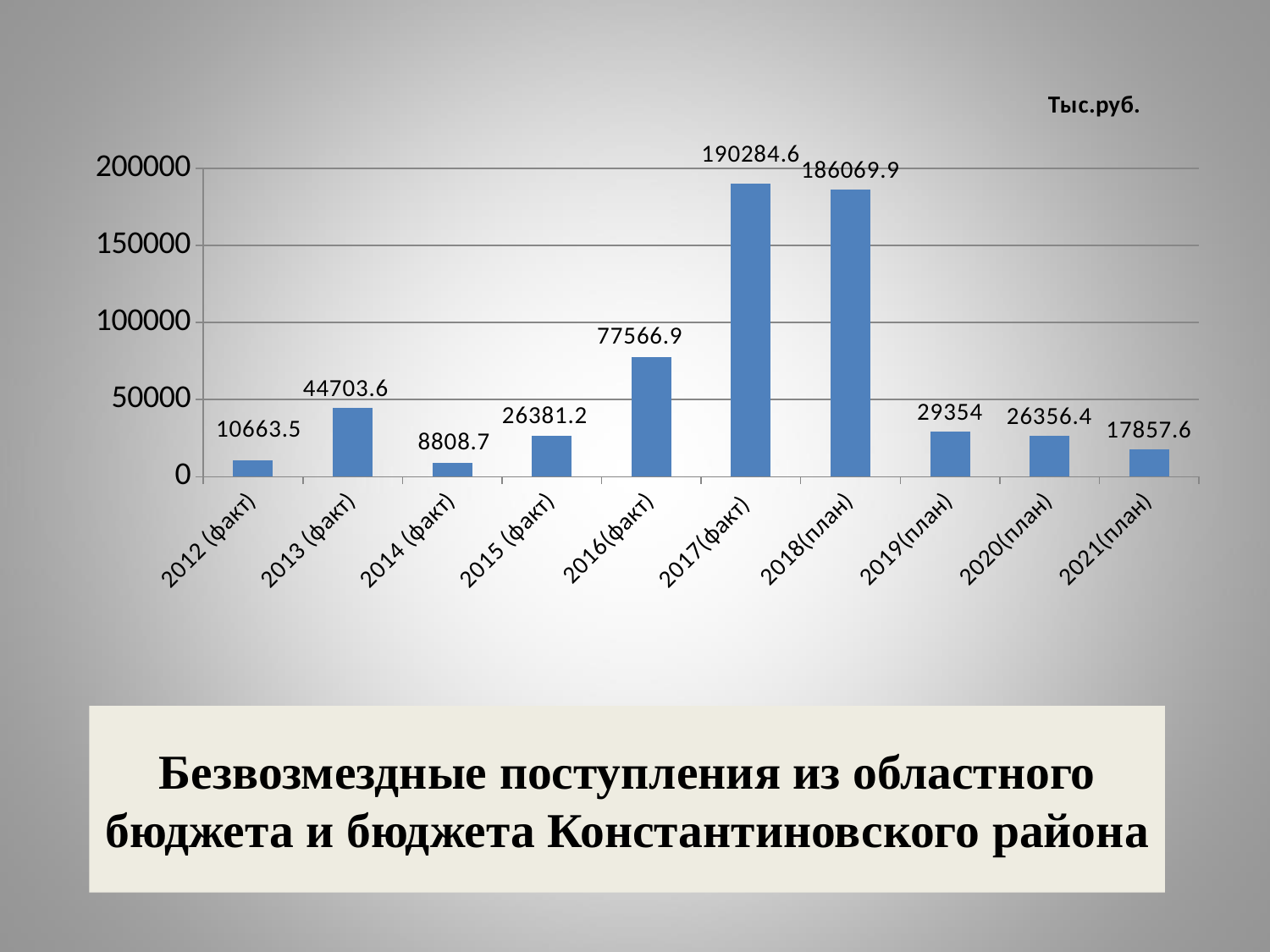
What is the value for 2017(факт)? 190284.6 Is the value for 2016(факт) greater or less than 50000? greater What kind of chart is shown on the slide? bar chart Which category has the highest value? 2017(факт) How many categories are shown on the x axis? 10 What is the value for 2019(план)? 29354 Which category has the lowest value? 2014 (факт) What is the difference between the values for 2013 (факт) and 2012 (факт)? 34040.1 What is the value for 2012 (факт)? 10663.5 Which is larger, the value for 2019(план) or the value for 2020(план)? 2019(план) What is the difference between the values for 2017(факт) and 2018(план)? 4214.7 What unit is indicated in the top right corner of the chart? Тыс.руб.